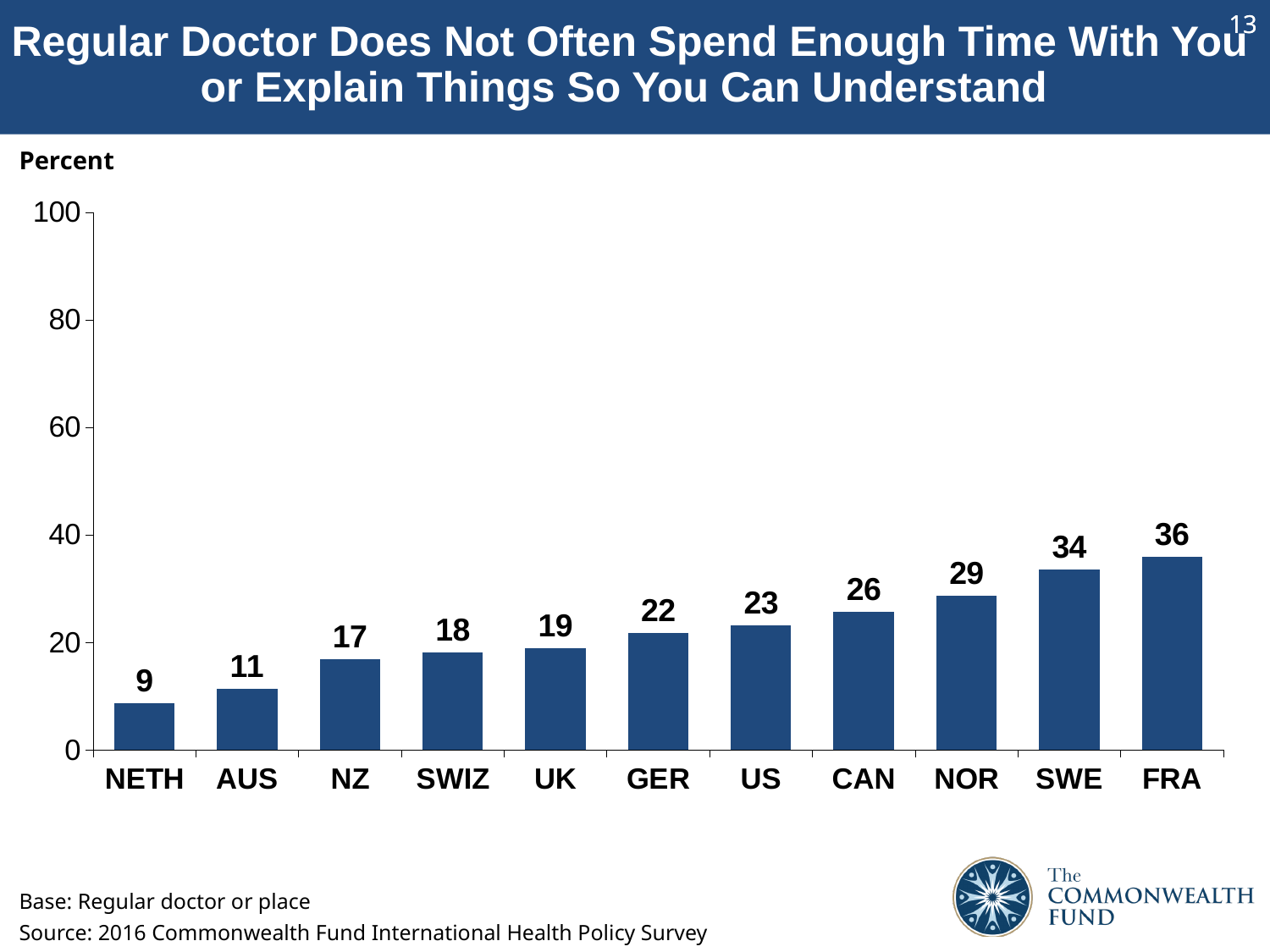
Do the values rise or fall from left to right along the x axis? Rise What is the value for SWE? 34 Which has a larger value, GER or AUS? GER Which country has the lowest value? NETH What is the difference between the values for NOR and CAN? 3 What is the value for the US? 23 What kind of chart is shown on the slide? Bar chart How many countries are shown on the chart? 11 What is the value for NETH? 9 Which country has the highest value? FRA Is the value for SWE greater or less than 20? greater What is the difference between the values for FRA and NETH? 27